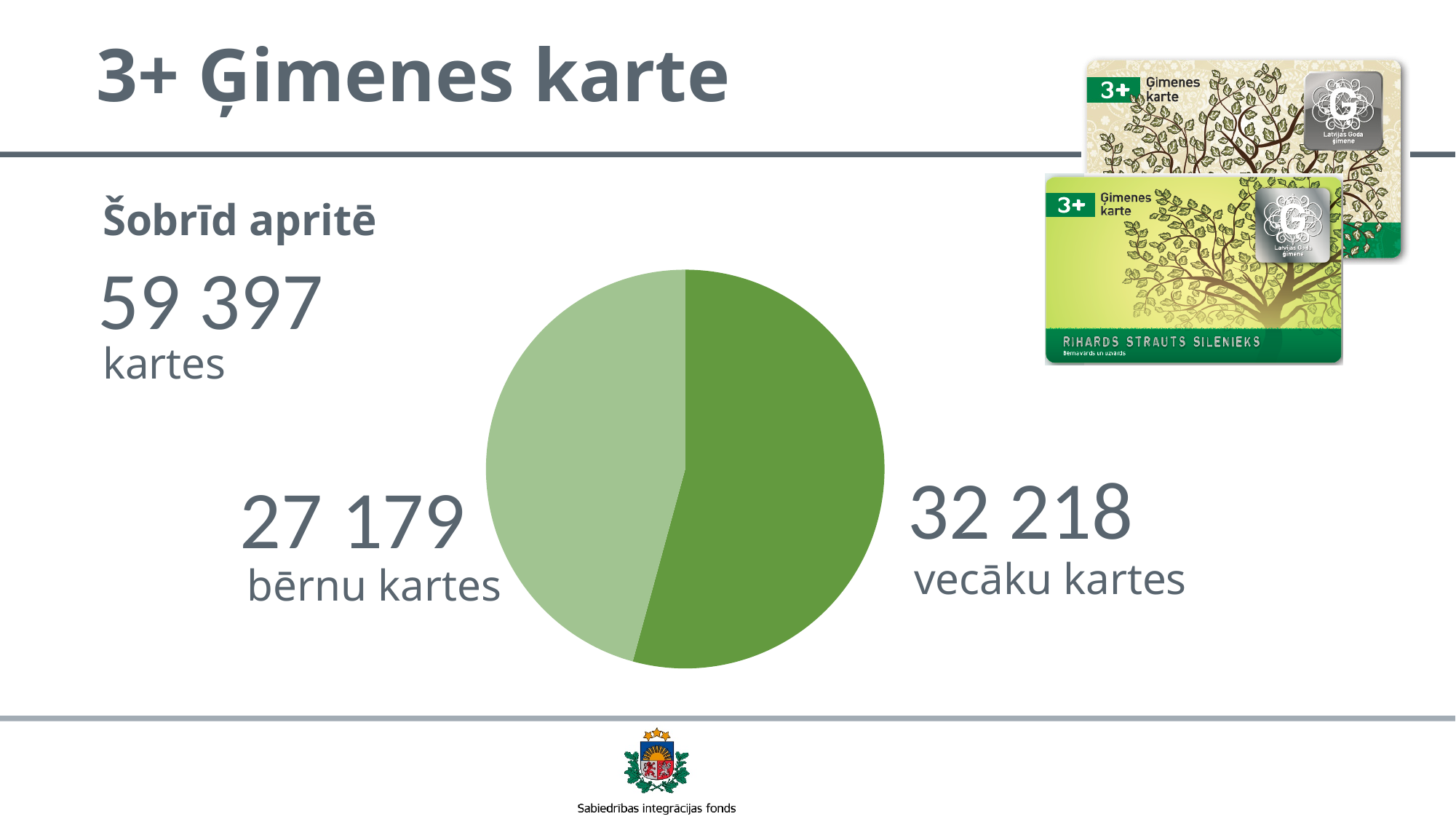
Which category has the larger slice in the pie chart? vecāku kartes Which slice of the pie chart is shown in the darker green? vecāku kartes Which category has the smaller slice in the pie chart? bērnu kartes How many slices does the pie chart have? 2 What is the title of the slide? 3+ Ģimenes karte How many bērnu kartes does the pie chart show? 27 179 Are there more bērnu kartes or vecāku kartes? vecāku kartes What is the difference between the number of vecāku kartes and bērnu kartes? 5 039 How many vecāku kartes does the pie chart show? 32 218 What is the total number of cards in circulation shown on the slide? 59 397 What kind of chart is shown on the slide? pie chart